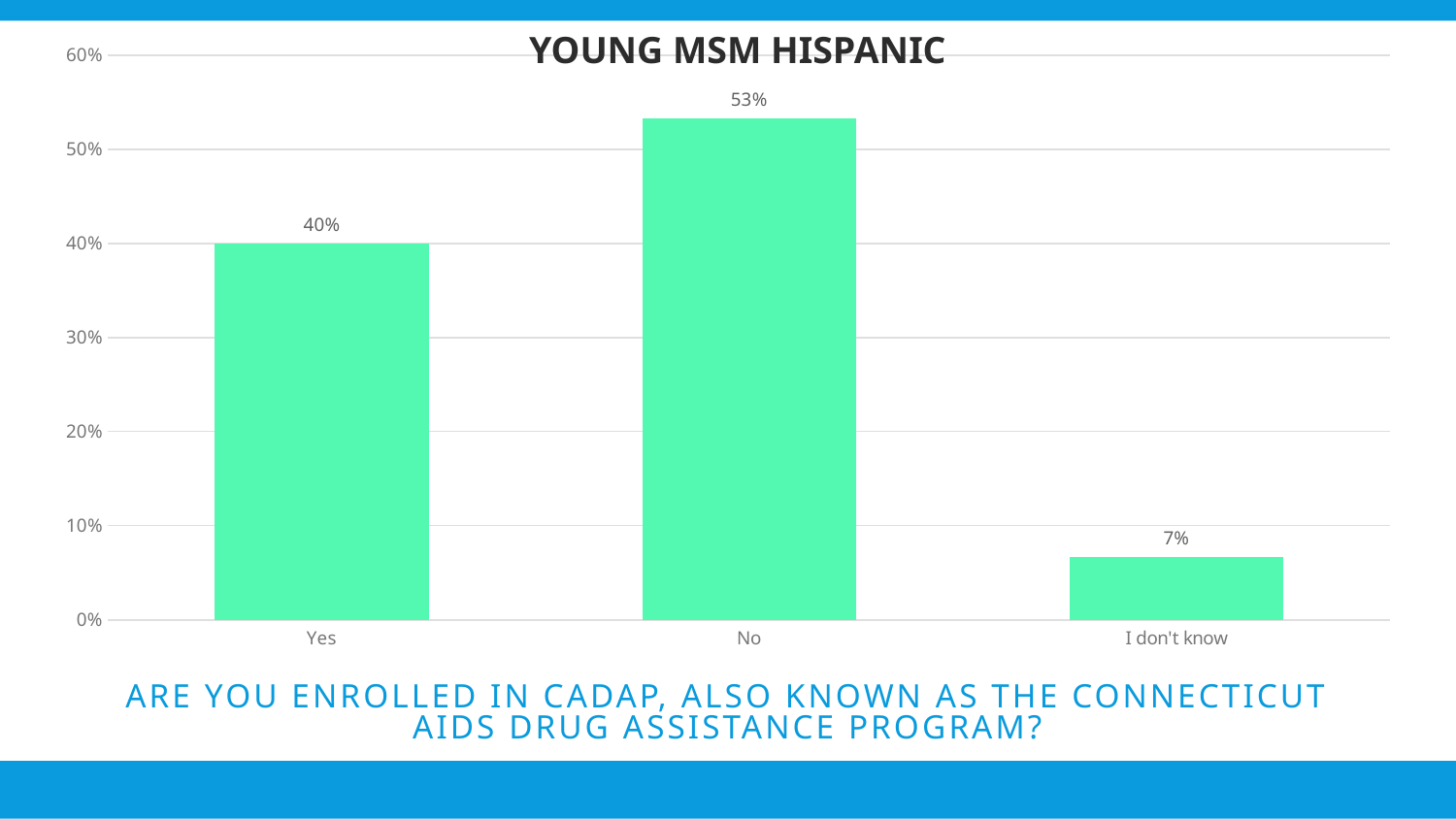
What percentage of respondents answered "No"? 53% What kind of chart is shown on the slide? Bar chart What is the title of the chart? YOUNG MSM HISPANIC What percentage of respondents answered "Yes"? 40% How many response categories are shown on the x axis? 3 Which response category has the lowest value? I don't know Is the value for "I don't know" greater or less than 10%? less Which is larger, the value for "Yes" or the value for "No"? No Which response category has the highest value? No What percentage of respondents answered "I don't know"? 7% What is the difference between the "Yes" and "I don't know" percentages? 33% What is the difference between the "No" and "Yes" percentages? 13%